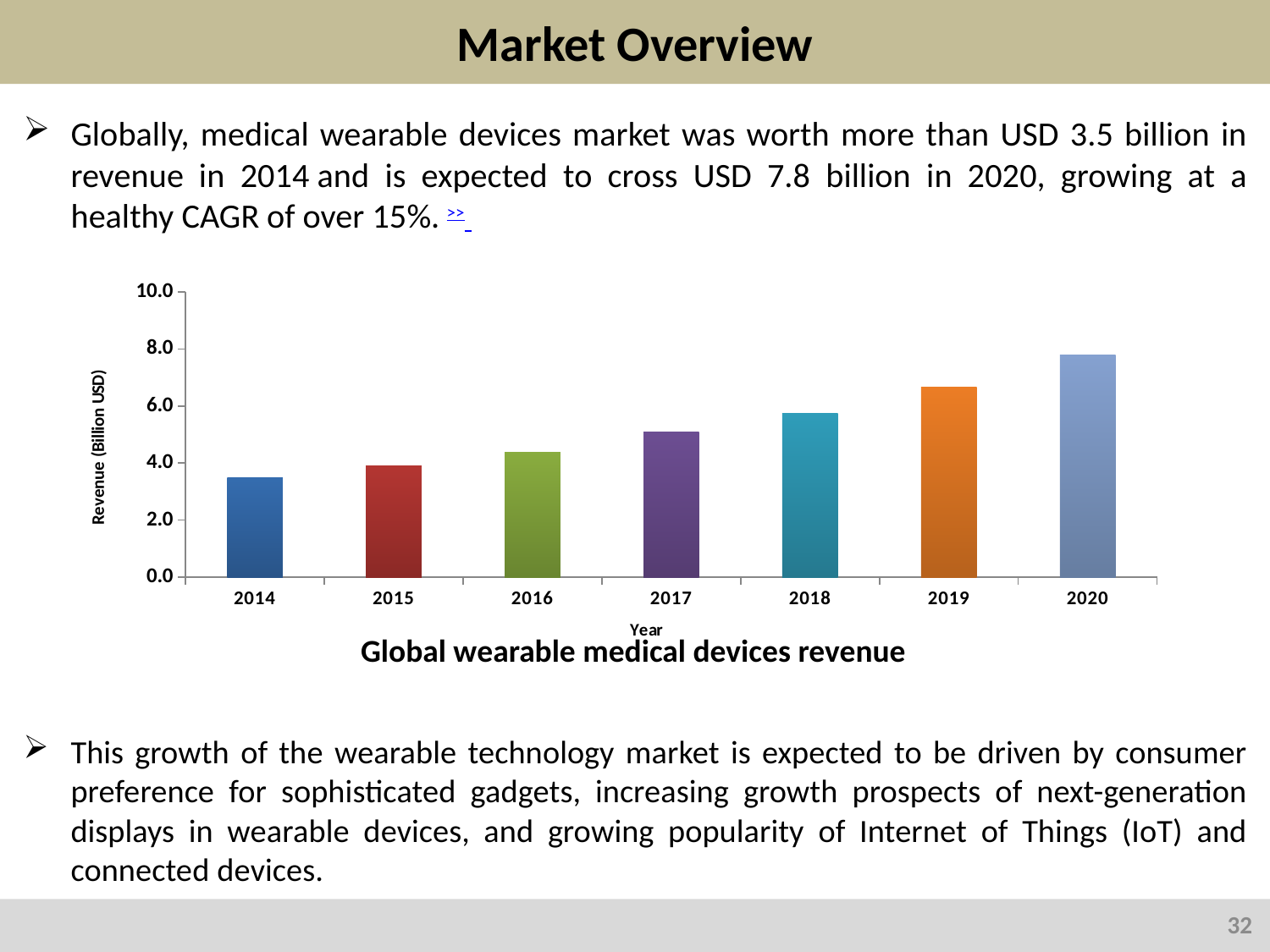
What is the title of the chart? Global wearable medical devices revenue Which year has the highest revenue in the chart? 2020 Which year has the larger revenue, 2015 or 2018? 2018 Is the revenue for 2016 greater or less than 4.0 billion USD? greater How many years are plotted in the chart? 7 Is the revenue for 2017 greater or less than 6.0 billion USD? less What kind of chart is shown on the slide? bar chart What is the label of the vertical axis of the chart? Revenue (Billion USD) Do the revenue values rise or fall from 2014 to 2020? rise Is the revenue for 2014 greater or less than 4.0 billion USD? less Which year has the lowest revenue in the chart? 2014